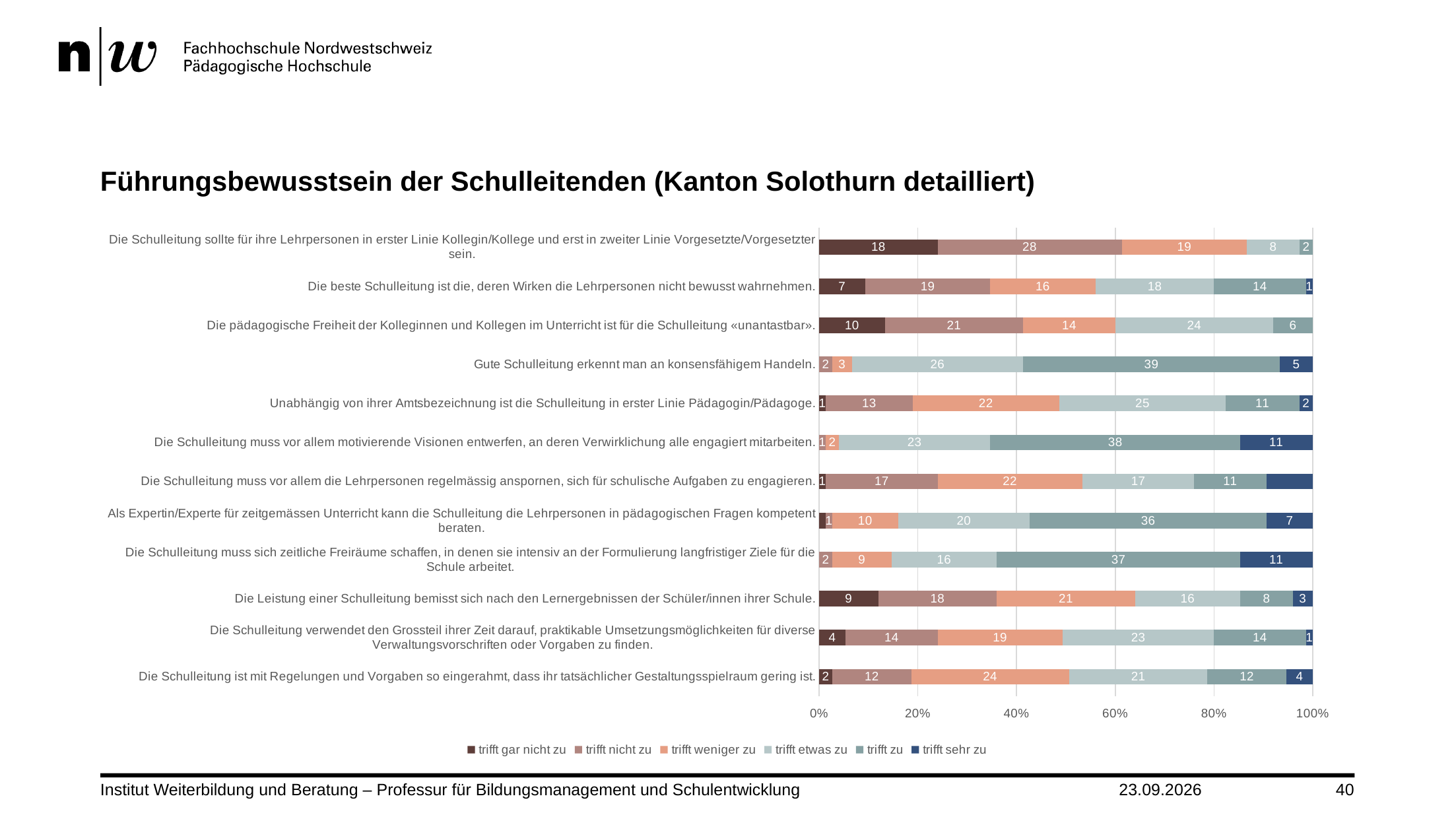
What is the total of all labelled segments for the statement "Die Leistung einer Schulleitung bemisst sich nach den Lernergebnissen der Schüler/innen ihrer Schule."? 75 What is the value for "trifft nicht zu" for the statement "Die Schulleitung sollte für ihre Lehrpersonen in erster Linie Kollegin/Kollege und erst in zweiter Linie Vorgesetzte/Vorgesetzter sein."? 28 What is the value for "trifft etwas zu" for the statement "Die pädagogische Freiheit der Kolleginnen und Kollegen im Unterricht ist für die Schulleitung «unantastbar»."? 24 What kind of chart is shown on the slide? Stacked bar chart How many series does the legend list? 6 How many statements (categories) are shown in the chart? 12 What is the value for "trifft sehr zu" for the statement "Die Schulleitung muss vor allem motivierende Visionen entwerfen, an deren Verwirklichung alle engagiert mitarbeiten."? 11 What is the value for "trifft zu" for the statement "Gute Schulleitung erkennt man an konsensfähigem Handeln."? 39 Which statement has the highest value for "trifft zu"? Gute Schulleitung erkennt man an konsensfähigem Handeln. For the statement "Die Schulleitung sollte für ihre Lehrpersonen in erster Linie Kollegin/Kollege und erst in zweiter Linie Vorgesetzte/Vorgesetzter sein.", what is the difference between "trifft nicht zu" and "trifft gar nicht zu"? 10 Which is larger for "trifft weniger zu": the statement "Die Schulleitung ist mit Regelungen und Vorgaben so eingerahmt, dass ihr tatsächlicher Gestaltungsspielraum gering ist." or "Die Leistung einer Schulleitung bemisst sich nach den Lernergebnissen der Schüler/innen ihrer Schule."? Die Schulleitung ist mit Regelungen und Vorgaben so eingerahmt, dass ihr tatsächlicher Gestaltungsspielraum gering ist. Which statement has the highest value for "trifft gar nicht zu"? Die Schulleitung sollte für ihre Lehrpersonen in erster Linie Kollegin/Kollege und erst in zweiter Linie Vorgesetzte/Vorgesetzter sein.